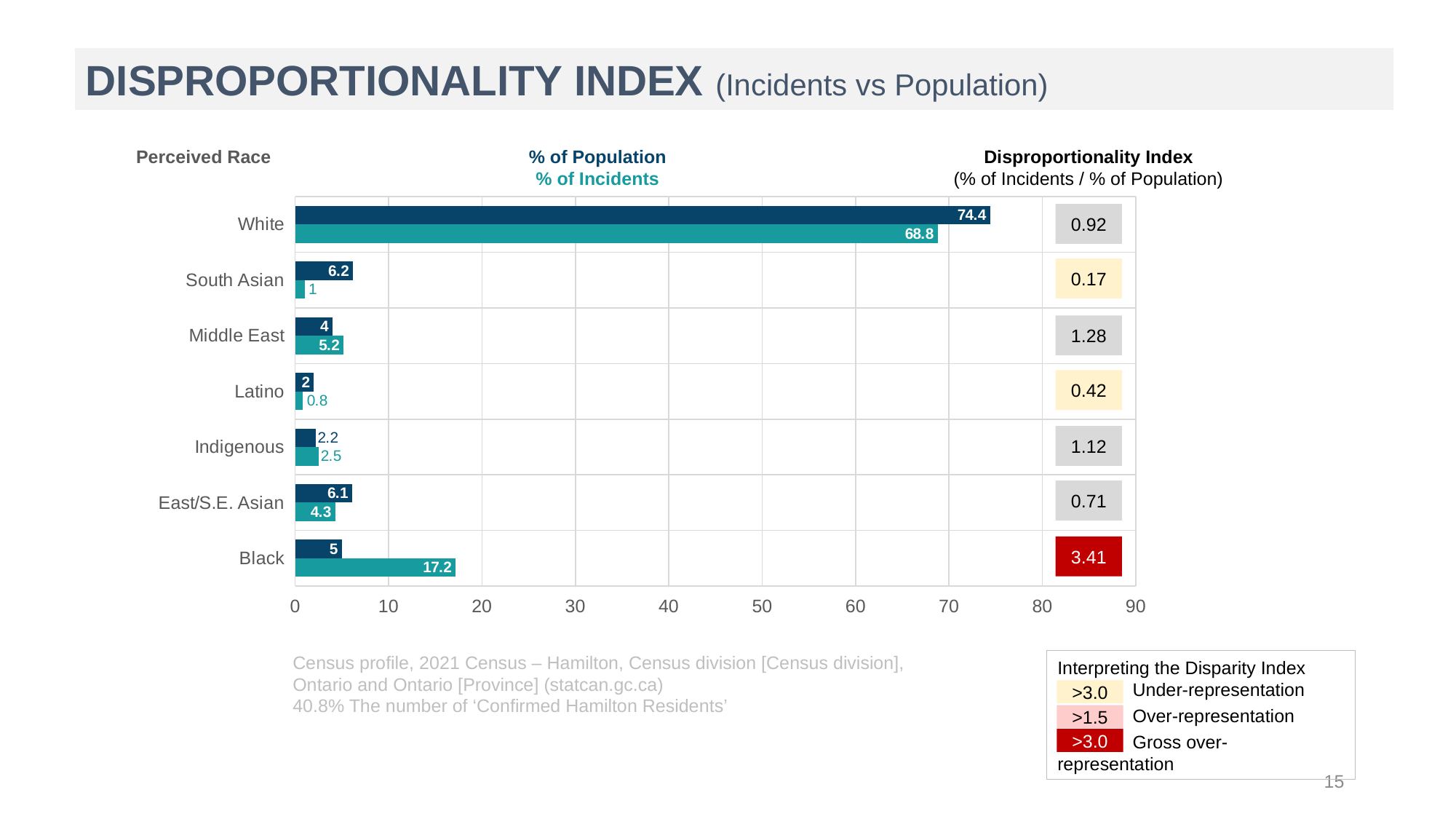
What is the % of Incidents value for Black? 17.2 What is the % of Population value for White? 74.4 What is the difference between the % of Population and % of Incidents for Black? 12.2 How many series does the chart plot? 2 How many perceived race categories are shown in the chart? 7 What is the Disproportionality Index value shown for Black? 3.41 Which perceived race has the lowest % of Population? Latino Is the % of Incidents value for White greater or less than 60? greater What kind of chart is shown on the slide? Bar chart What is the % of Incidents value for South Asian? 1 Which perceived race has the highest % of Incidents? White For East/S.E. Asian, which is larger: % of Population or % of Incidents? % of Population